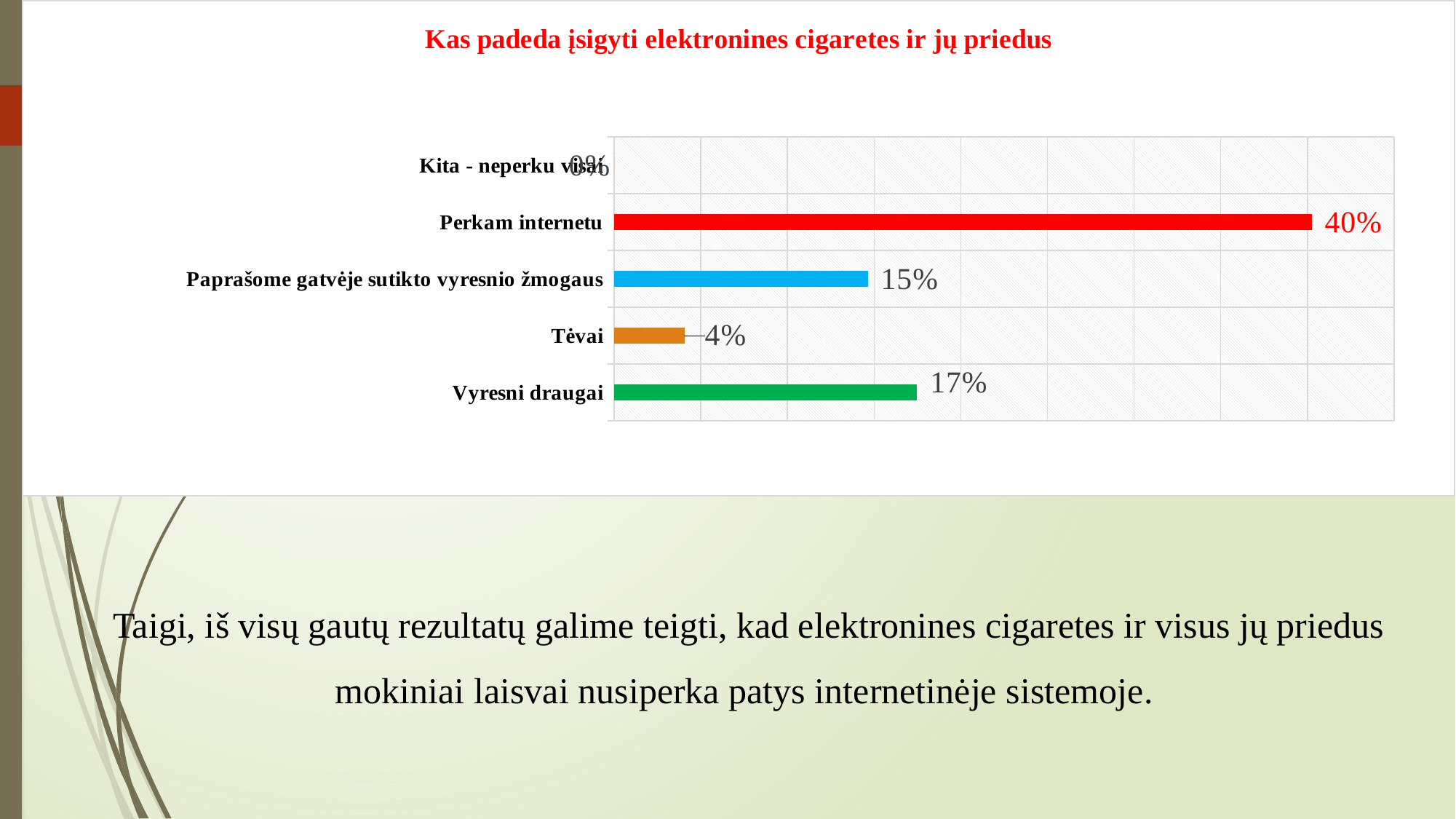
What is the title of the chart? Kas padeda įsigyti elektronines cigaretes ir jų priedus What kind of chart is shown on the slide? Bar chart What is the value for Paprašome gatvėje sutikto vyresnio žmogaus? 15% What is the difference between the values for Vyresni draugai and Tėvai? 13% What is the value for Vyresni draugai? 17% What is the difference between the values for Perkam internetu and Vyresni draugai? 23% Which category has the highest value? Perkam internetu Which is larger, the value for Vyresni draugai or the value for Paprašome gatvėje sutikto vyresnio žmogaus? Vyresni draugai What is the value for Tėvai? 4% Which category has the lowest value? Kita - neperku visai What is the value for Perkam internetu? 40% How many categories are shown in the chart? 5